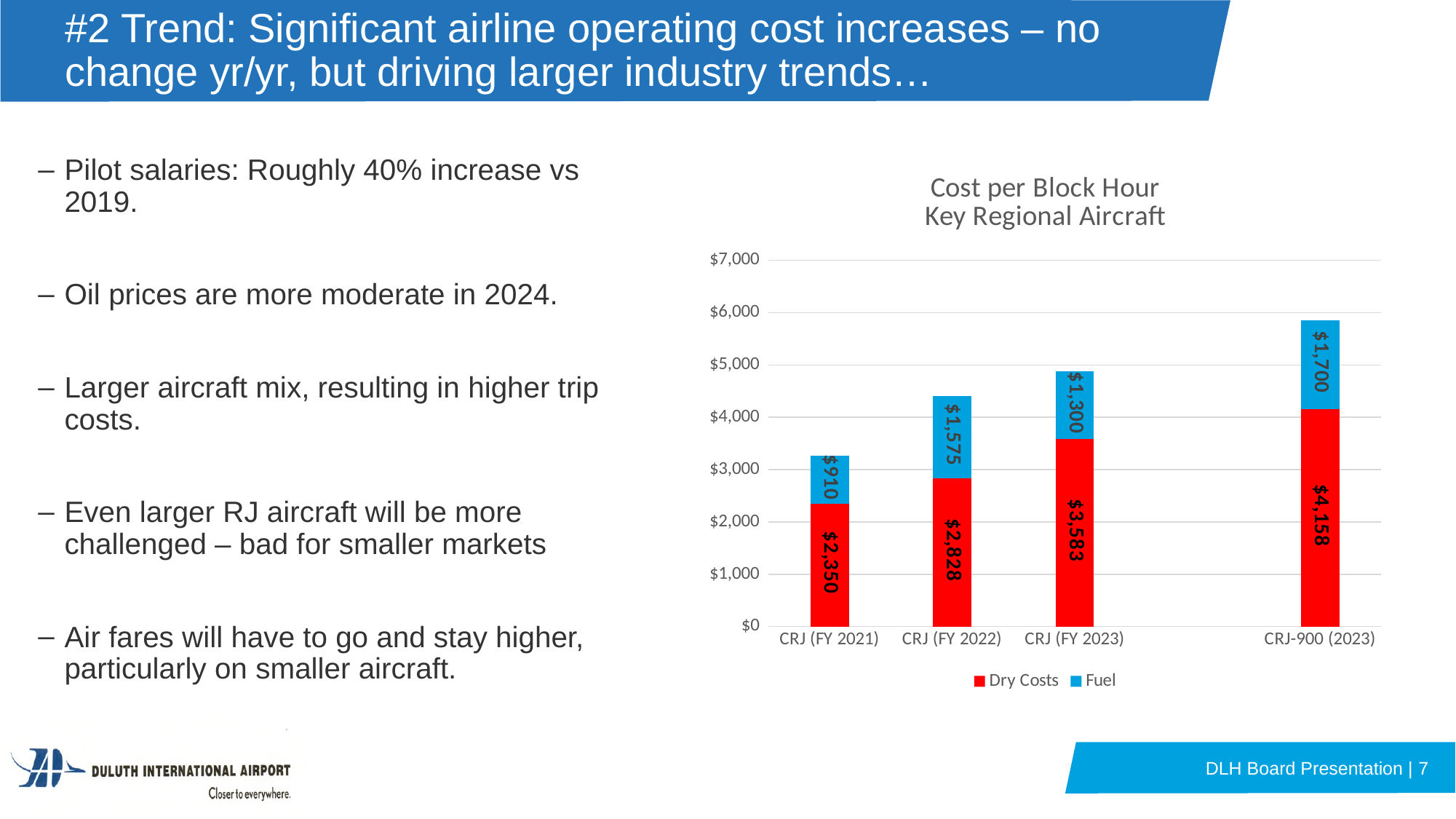
What is the difference between the Dry Costs values for CRJ (FY 2023) and CRJ (FY 2022)? $755 How many aircraft categories are shown on the x axis? 4 What is the total cost per block hour for CRJ (FY 2021), adding Dry Costs and Fuel? $3,260 Which is larger, the Fuel value for CRJ (FY 2022) or for CRJ (FY 2023)? CRJ (FY 2022) What is the Dry Costs value for CRJ-900 (2023)? $4,158 What is the Fuel value for CRJ (FY 2022)? $1,575 Which category has the lowest Fuel value? CRJ (FY 2021) What is the Fuel value for CRJ (FY 2023)? $1,300 What is the Dry Costs value for CRJ (FY 2021)? $2,350 Is the total bar height for CRJ-900 (2023) greater or less than $5,000? greater What type of chart is shown on the slide? Stacked bar chart Which category has the highest Dry Costs value? CRJ-900 (2023)